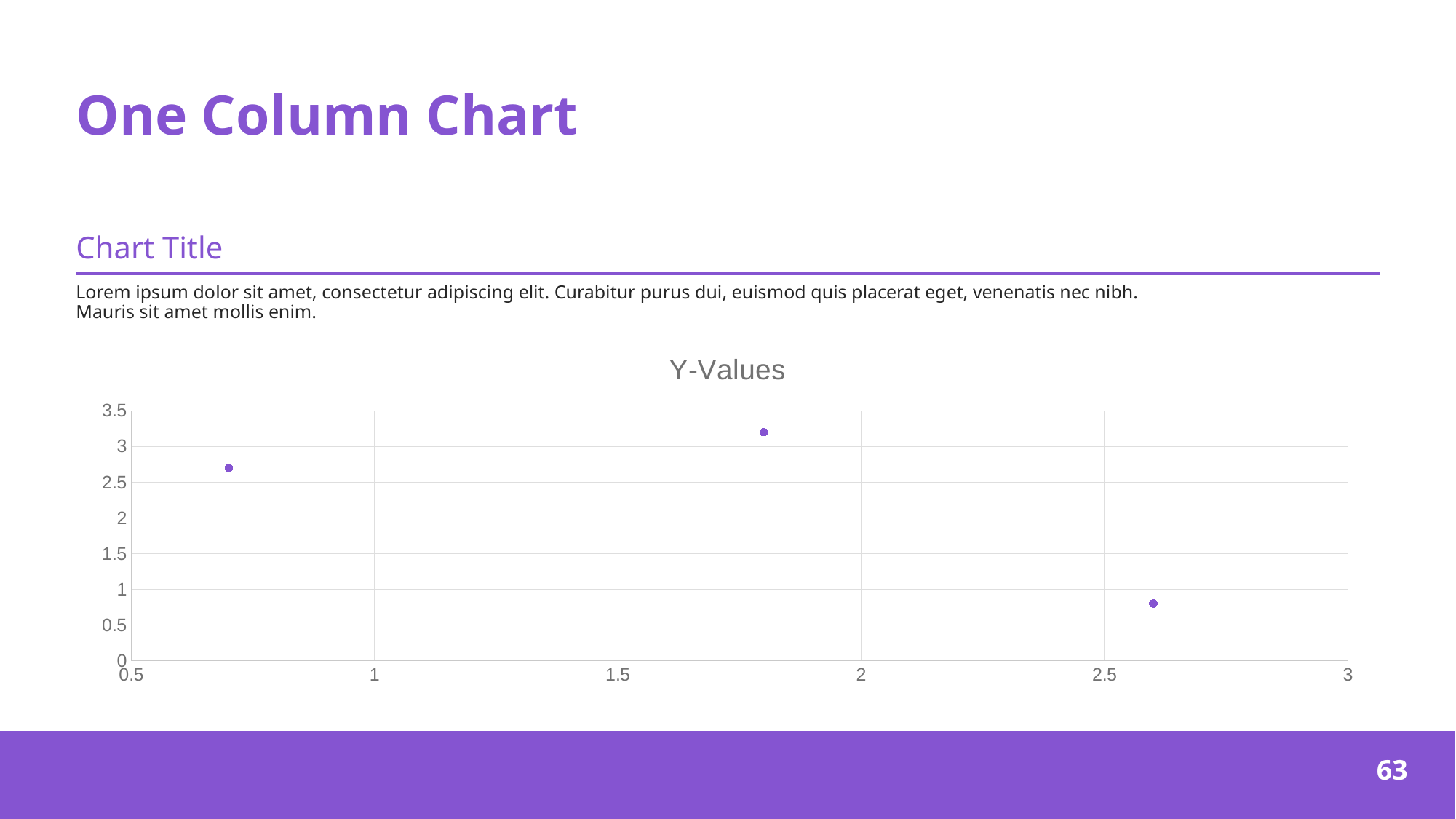
Do the values rise or fall from the middle point to the rightmost point? fall Which point has the highest value: the leftmost, middle, or rightmost? middle What is the highest value shown on the y axis? 3.5 What kind of chart is shown on the slide? scatter chart How many data points are plotted in the chart? 3 Is the value of the rightmost point greater or less than 1? less What is the title of the chart? Y-Values Which has the larger value, the leftmost point or the rightmost point? leftmost point Is the value of the middle point greater or less than 3? greater Which point has the lowest value: the leftmost, middle, or rightmost? rightmost Is the value of the leftmost point greater or less than 3? less